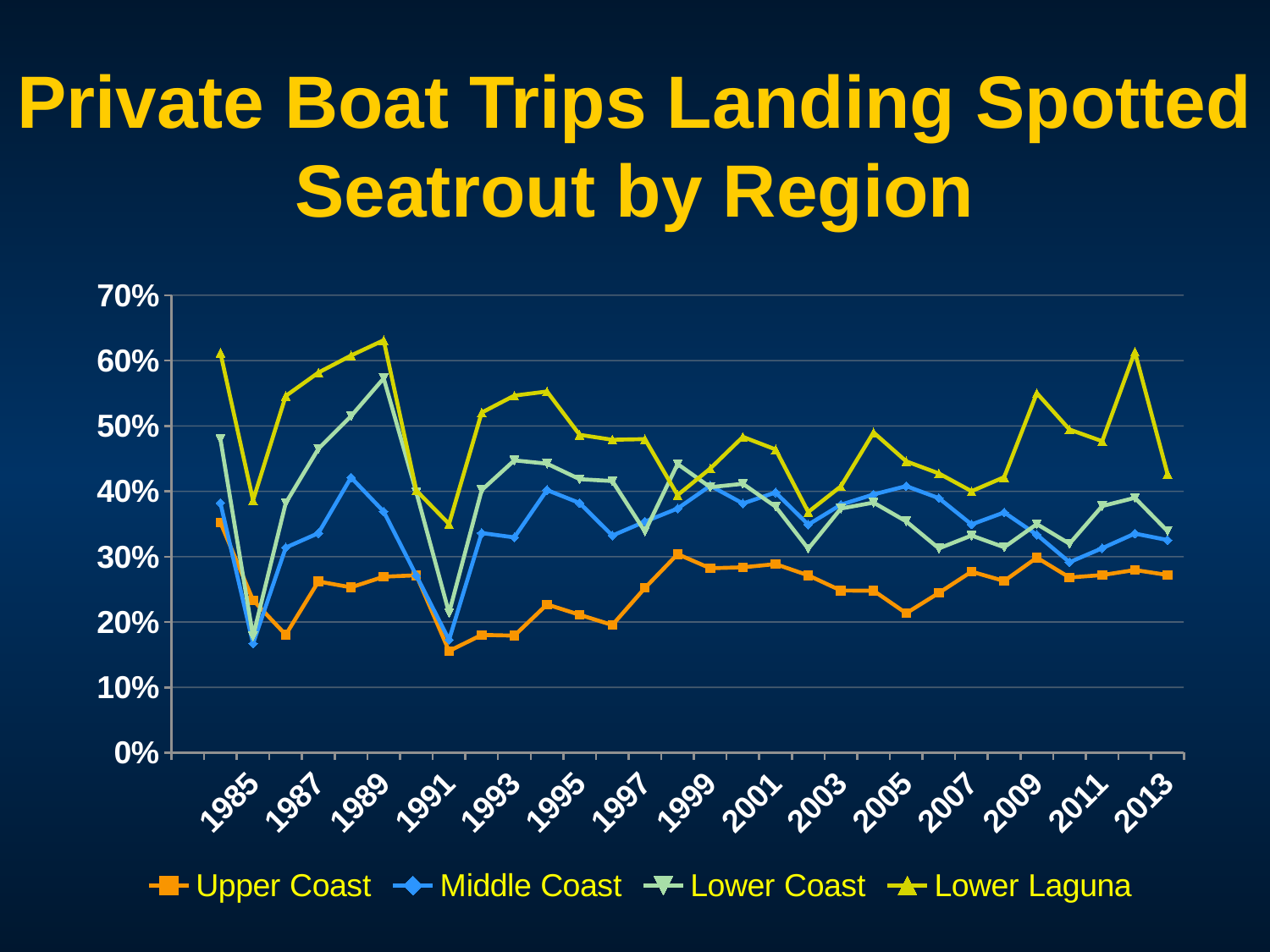
Which series is represented by the orange line with square markers? Upper Coast How many series does the legend list? 4 How many year labels are shown on the x axis? 15 Is the value for Upper Coast in 2013 greater or less than 30%? less In which year does the Upper Coast series reach its lowest value? 1991 In 1989, which is larger: the value for Lower Laguna or the value for Upper Coast? Lower Laguna Is the value for Upper Coast in 1991 greater or less than 20%? less What is the title of the chart? Private Boat Trips Landing Spotted Seatrout by Region Which region has the highest value in 1989? Lower Laguna Which region has the lowest value in 2013? Upper Coast What kind of chart is shown on the slide? line chart Is the value for Lower Laguna in 1989 greater or less than 60%? greater